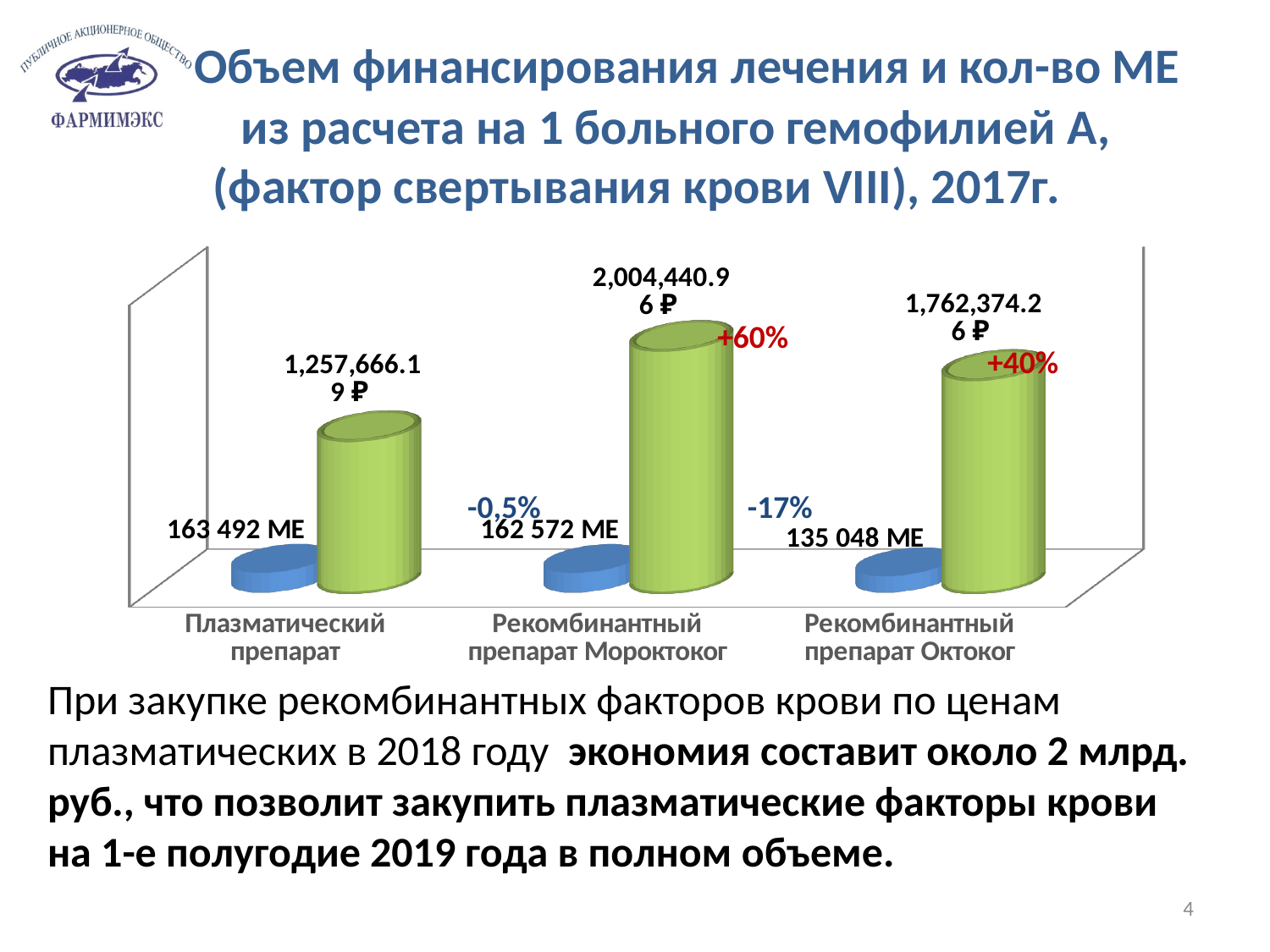
What is the funding value shown for Рекомбинантный препарат Мороктоког? 2,004,440.96 ₽ How many МЕ are shown for Рекомбинантный препарат Мороктоког? 162 572 МЕ Which has a larger funding value: Рекомбинантный препарат Октоког or Плазматический препарат? Рекомбинантный препарат Октоког What is the funding value shown for Плазматический препарат? 1,257,666.19 ₽ What percentage annotation in red is shown next to the bar for Рекомбинантный препарат Октоког? +40% What kind of chart is shown on the slide? Bar chart How many МЕ are shown for Рекомбинантный препарат Октоког? 135 048 МЕ What is the difference in МЕ between Плазматический препарат and Рекомбинантный препарат Октоког? 28 444 МЕ Which category has the lowest number of МЕ? Рекомбинантный препарат Октоког How many categories are shown on the x axis of the chart? 3 What is the difference in funding between Рекомбинантный препарат Мороктоког and Плазматический препарат? 746,774.77 ₽ Which category has the highest funding value in rubles? Рекомбинантный препарат Мороктоког